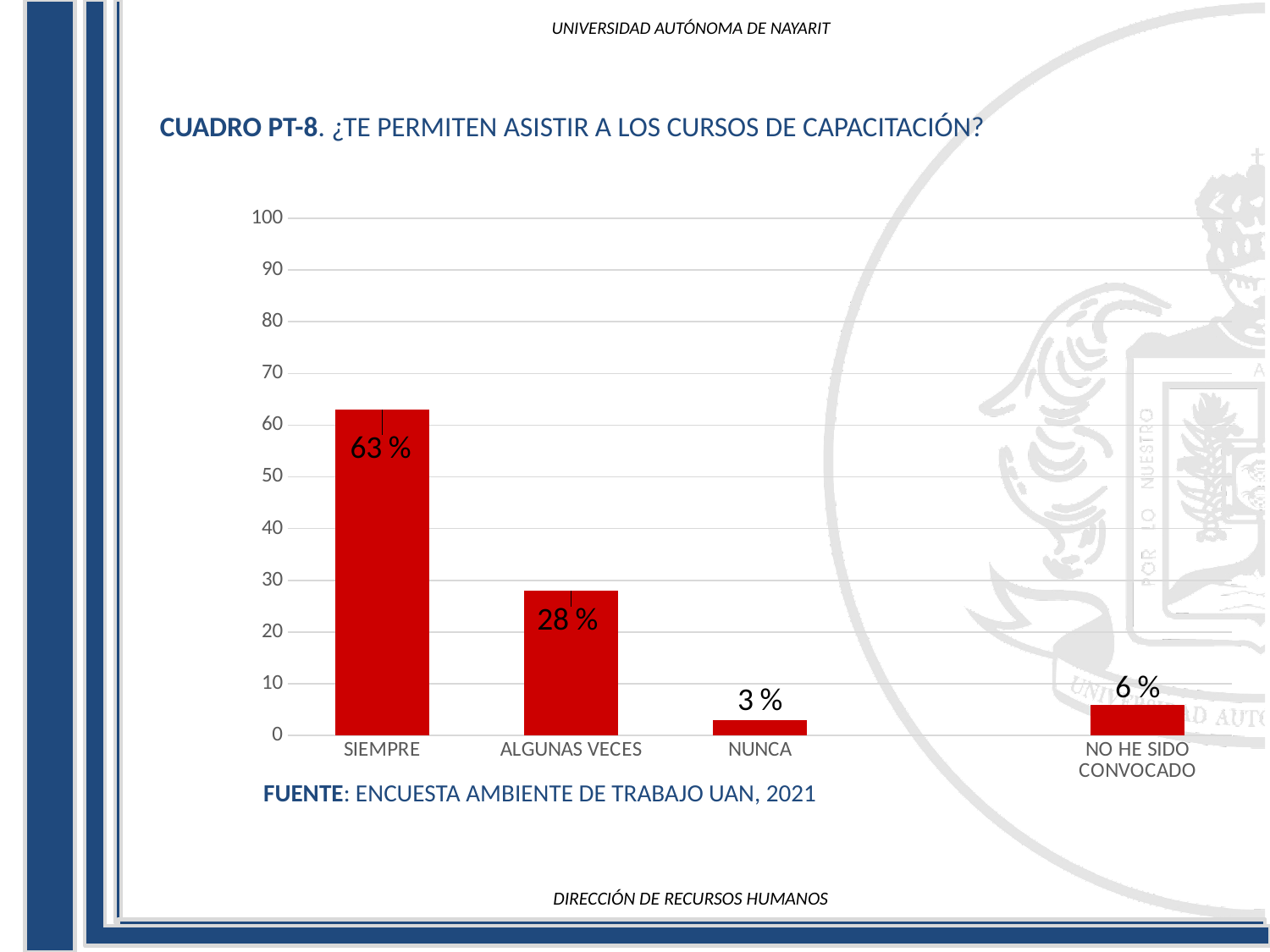
How many categories are shown on the x axis? 4 What kind of chart is shown on the slide? bar chart Which category has the highest value? SIEMPRE Is the value for SIEMPRE greater or less than 60? greater What is the value for NUNCA? 3 % What is the difference between the values for SIEMPRE and ALGUNAS VECES? 35 % What is the value for SIEMPRE? 63 % Which category has the lowest value? NUNCA What is the source cited below the chart? ENCUESTA AMBIENTE DE TRABAJO UAN, 2021 Which is larger, the value for NO HE SIDO CONVOCADO or the value for NUNCA? NO HE SIDO CONVOCADO What is the value for NO HE SIDO CONVOCADO? 6 % What is the value for ALGUNAS VECES? 28 %